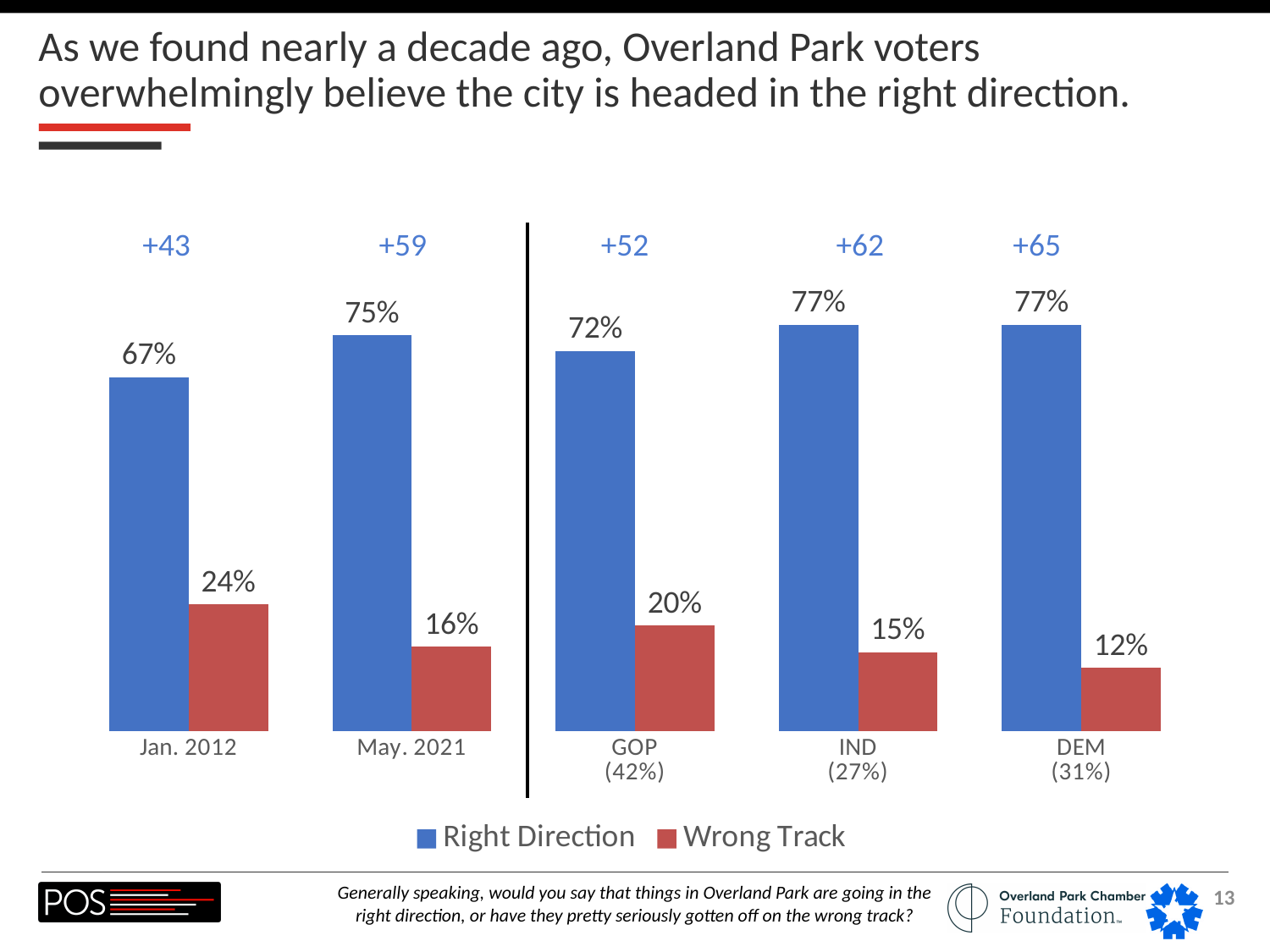
What kind of chart is shown on the slide? Bar chart What colour represents the "Wrong Track" series? Red Which category has the highest "Wrong Track" value? Jan. 2012 Which is larger, the "Wrong Track" value for GOP or for IND? GOP What is the "Wrong Track" value for Jan. 2012? 24% By how many percentage points did the "Right Direction" value increase from Jan. 2012 to May 2021? 8 What is the difference between the "Right Direction" and "Wrong Track" values for GOP voters? 52 Which category has the lowest "Right Direction" value? Jan. 2012 How many categories are shown on the x axis of the chart? 5 What is the "Wrong Track" value for DEM voters? 12% How many series does the legend list? 2 What percentage of Overland Park voters said "Right Direction" in May 2021? 75%